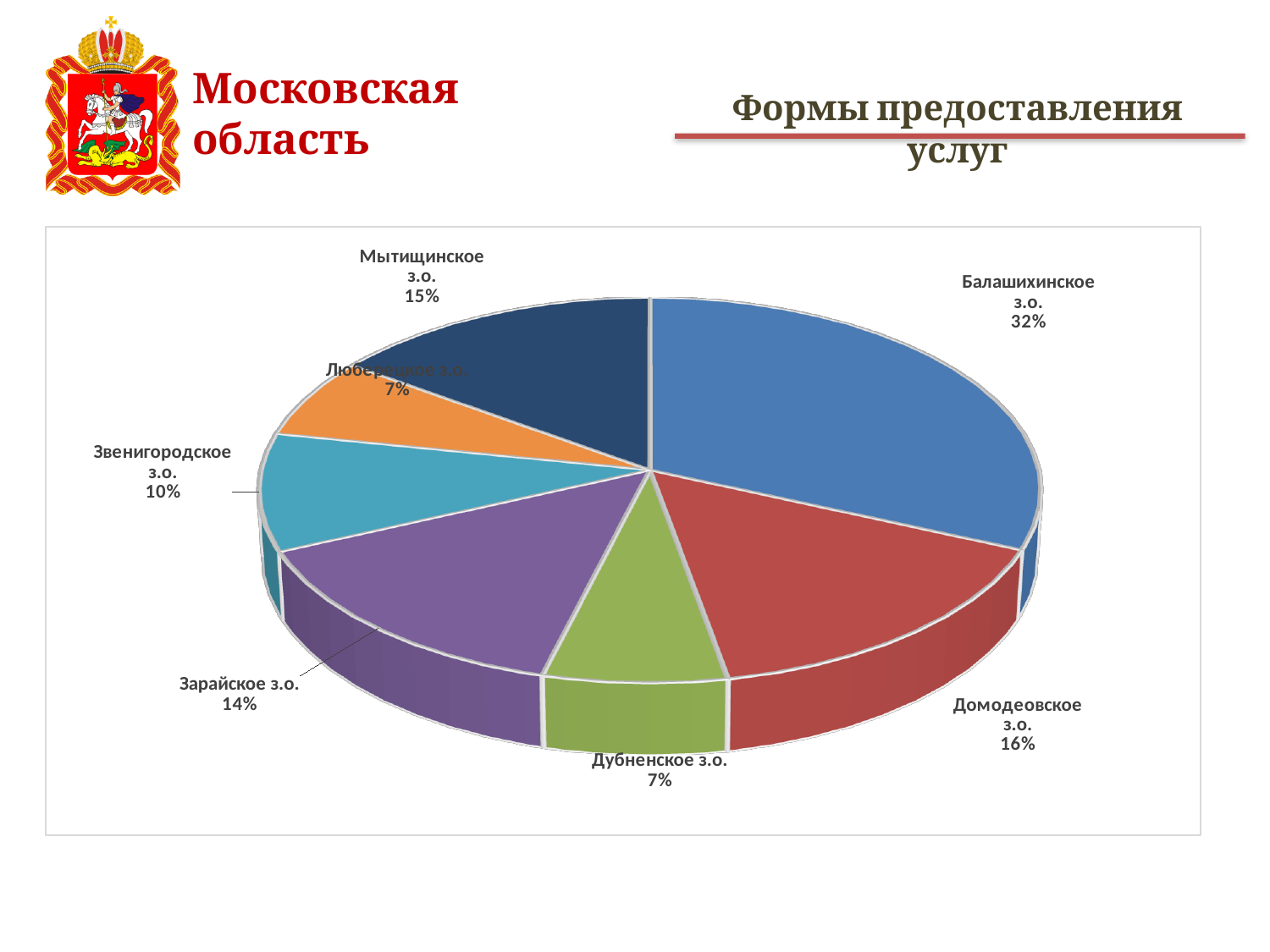
What share does Домодеовское з.о. have in the pie chart? 16% Which category has the largest slice in the pie chart? Балашихинское з.о. What share does Дубненское з.о. have in the pie chart? 7% What colour is the slice for Балашихинское з.о.? blue What share does Балашихинское з.о. have in the pie chart? 32% What is the difference in percentage points between Балашихинское з.о. and Домодеовское з.о.? 16 Which is larger, the share of Мытищинское з.о. or the share of Зарайское з.о.? Мытищинское з.о. What kind of chart is shown on the slide? pie chart How many slices does the pie chart have? 7